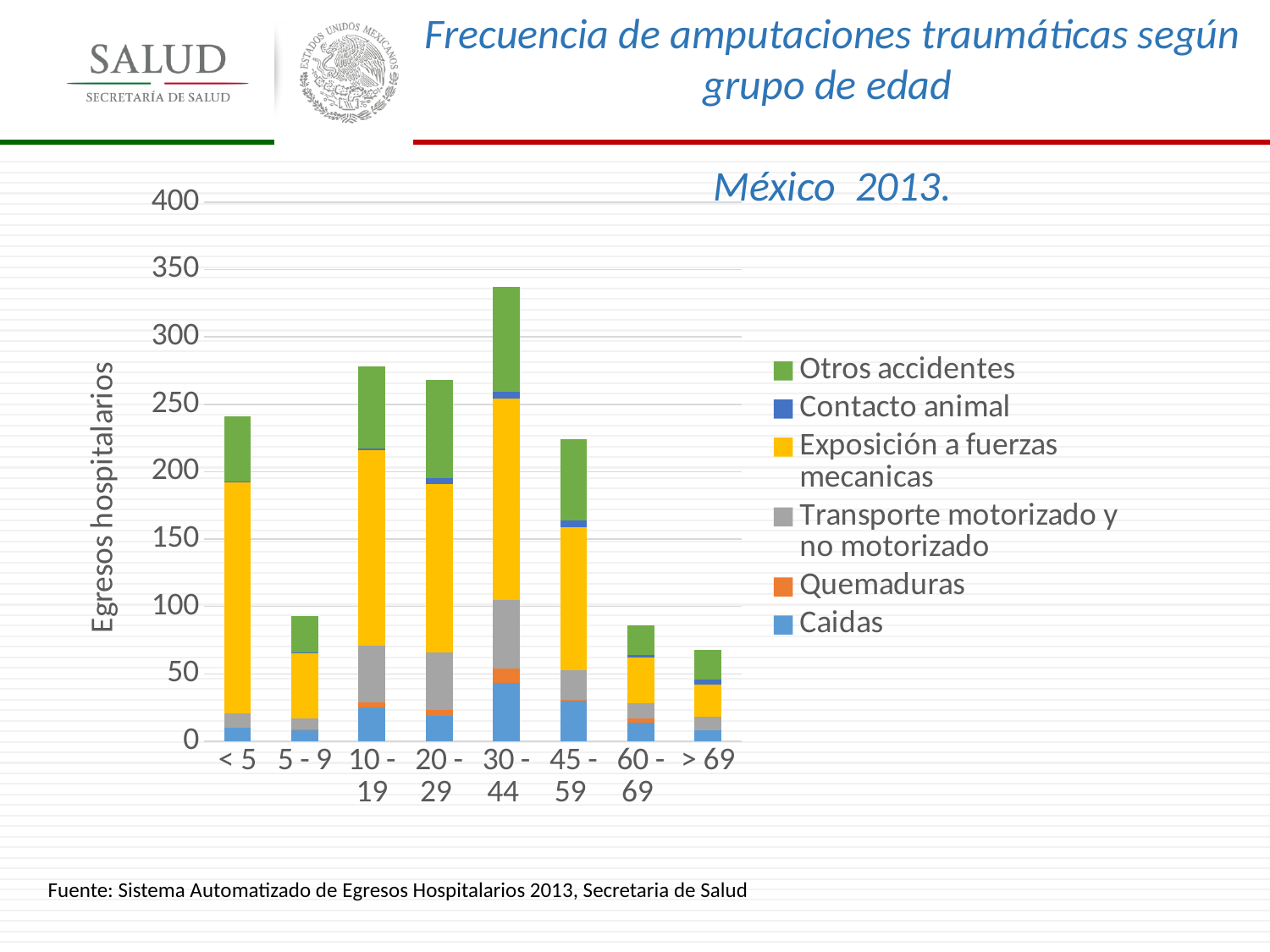
Which series is shown in yellow in the legend? Exposición a fuerzas mecanicas Which age group has the lowest total number of hospital discharges? > 69 Is the total for the 60 - 69 age group greater or less than 100? less Is the total for the < 5 age group greater or less than 200? greater Which age group has the highest total number of hospital discharges? 30 - 44 Which has a larger total, the 30 - 44 age group or the 10 - 19 age group? 30 - 44 What is the label of the vertical axis? Egresos hospitalarios Is the total for the 30 - 44 age group greater or less than 300? greater How many series does the legend list? 6 What kind of chart is shown on the slide? Stacked bar chart How many age groups are shown along the x axis? 8